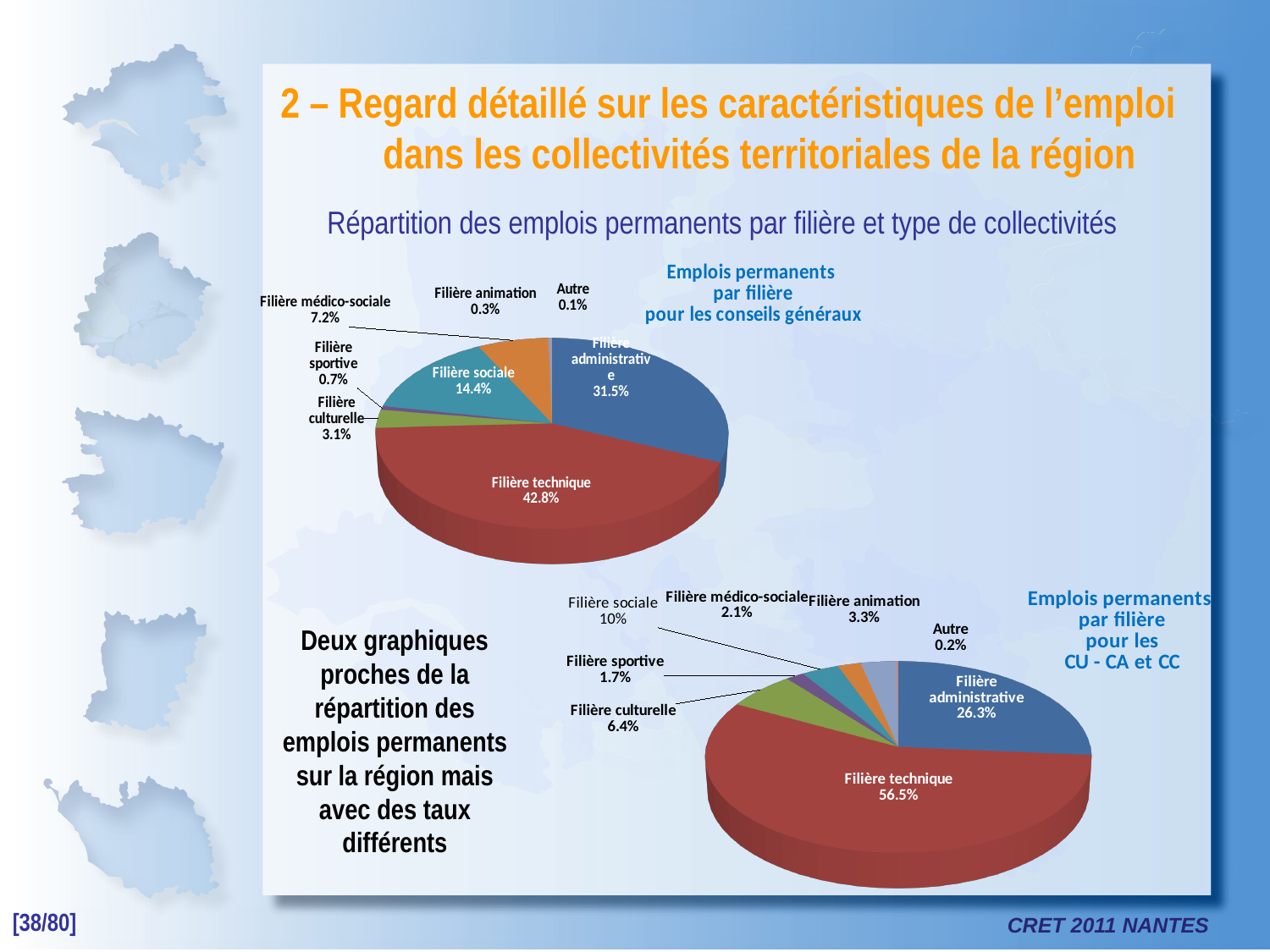
Which chart shows the higher share for Filière technique, the one for the conseils généraux or the one for the CU - CA et CC? CU - CA et CC In the chart 'Emplois permanents par filière pour les CU - CA et CC', what share is Filière culturelle? 6.4% In the chart 'Emplois permanents par filière pour les CU - CA et CC', which is larger, Filière sociale or Filière animation? Filière sociale In the chart 'Emplois permanents par filière pour les CU - CA et CC', which filière has the largest share? Filière technique How many slices does the chart 'Emplois permanents par filière pour les CU - CA et CC' have? 8 In the chart 'Emplois permanents par filière pour les CU - CA et CC', what share is Filière administrative? 26.3% In the chart 'Emplois permanents par filière pour les conseils généraux', what share is Filière technique? 42.8% In the chart 'Emplois permanents par filière pour les conseils généraux', which filière has the largest share? Filière technique What type of chart is 'Emplois permanents par filière pour les conseils généraux'? Pie chart In the chart 'Emplois permanents par filière pour les conseils généraux', which category has the smallest share? Autre In the chart 'Emplois permanents par filière pour les conseils généraux', what share is Filière sociale? 14.4% In the chart 'Emplois permanents par filière pour les conseils généraux', what is the difference between Filière technique and Filière administrative? 11.3%